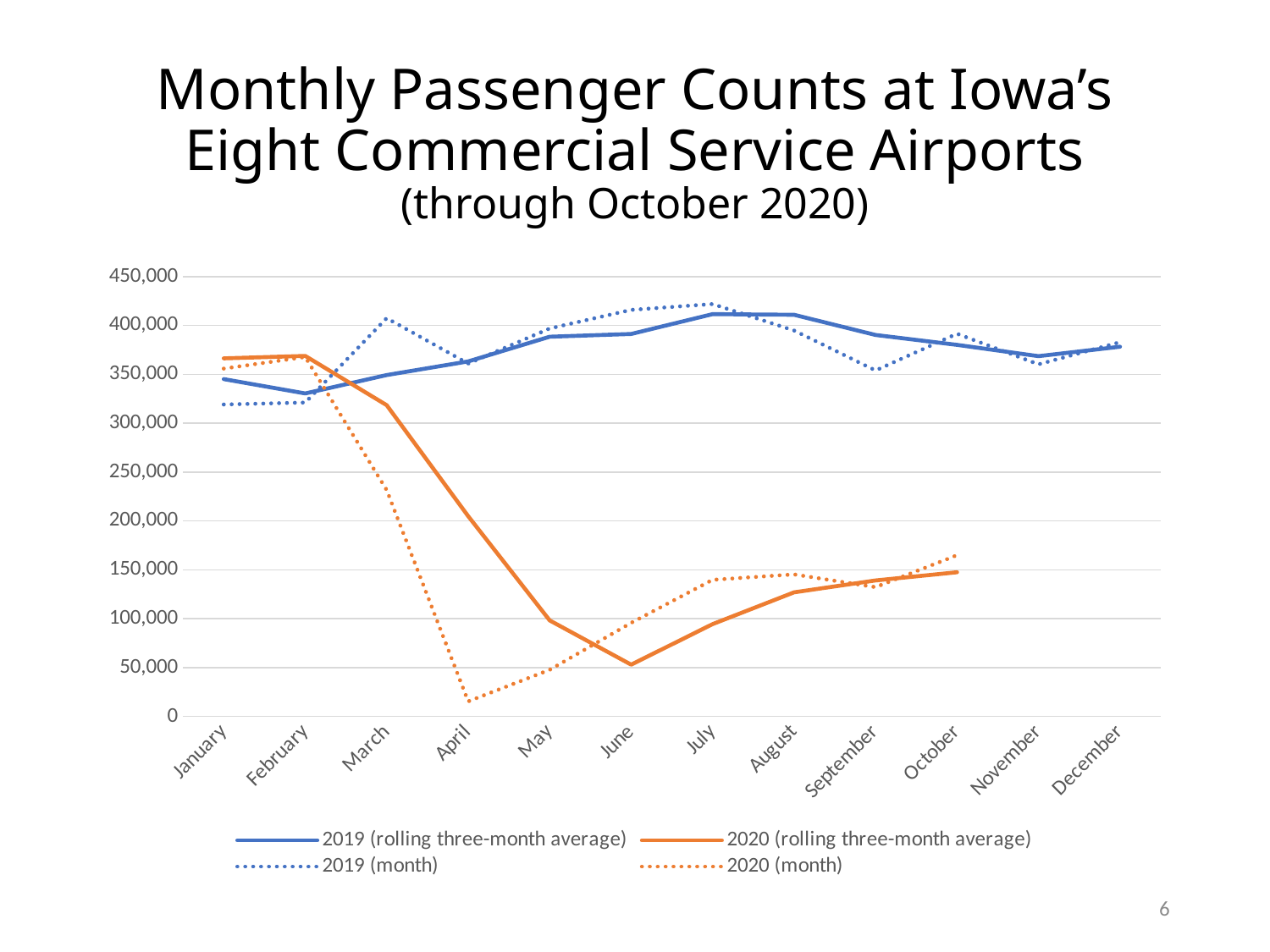
Is the value for July in the 2019 (rolling three-month average) series greater or less than 400,000? greater In January, which is larger: the 2019 (rolling three-month average) or the 2020 (rolling three-month average)? 2020 (rolling three-month average) How many series does the legend list? 4 In which month is the 2020 (rolling three-month average) series at its lowest? June Is the value for April in the 2020 (month) series greater or less than 50,000? less What is the last month for which the 2020 series have data? October How many months are shown along the x axis? 12 What type of chart is shown on the slide? line chart Is the value for October in the 2020 (month) series greater or less than 150,000? greater Does the 2020 (rolling three-month average) series rise or fall from March to June? fall In which month is the 2020 (month) series at its lowest? April In June, which is larger: the 2019 (rolling three-month average) or the 2020 (rolling three-month average)? 2019 (rolling three-month average)